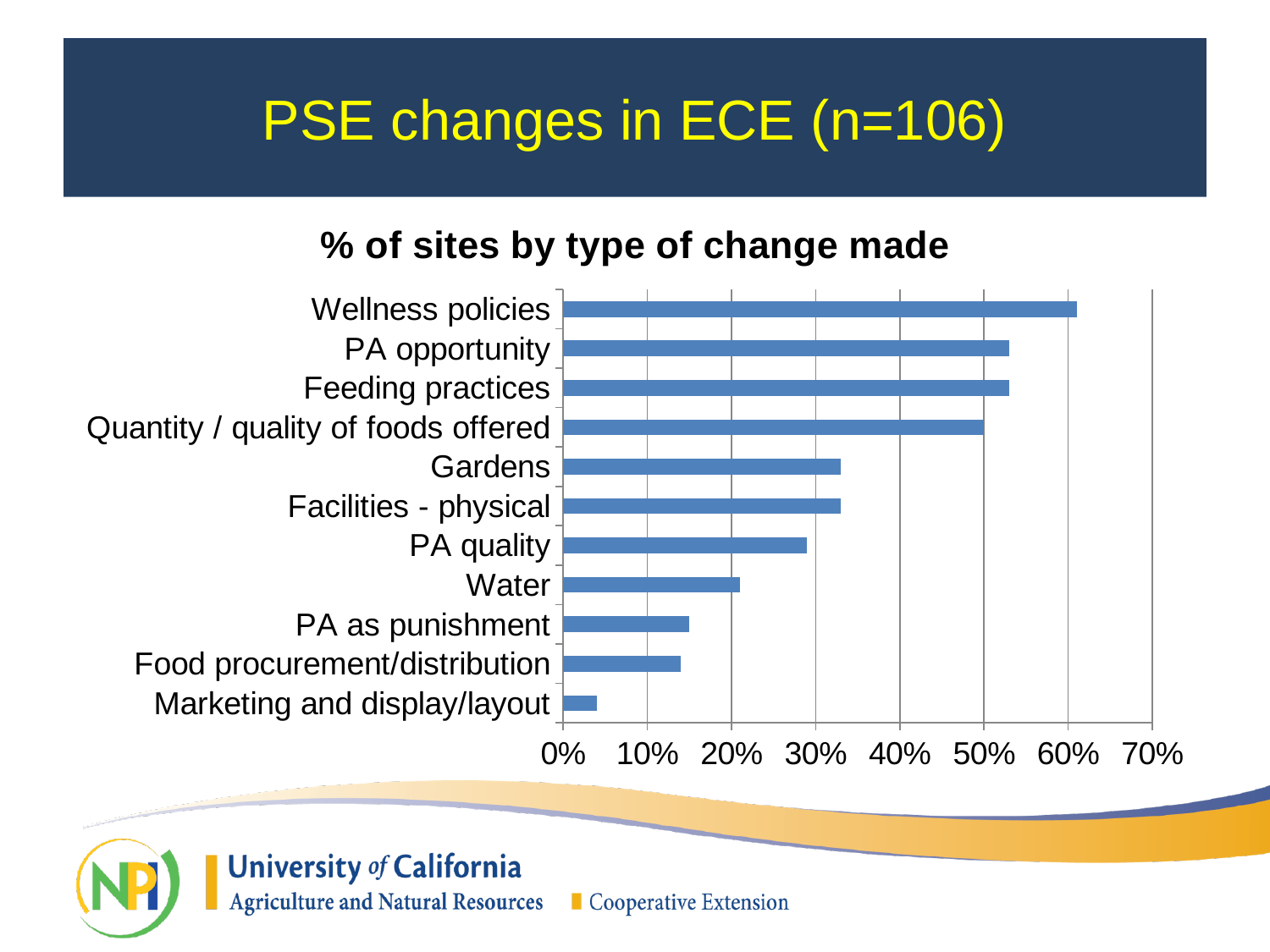
Which has a higher percentage of sites, PA quality or PA as punishment? PA quality Is the value for Gardens greater or less than 30%? greater Is the value for Marketing and display/layout greater or less than 10%? less Which type of change has the highest percentage of sites? Wellness policies What is the title of the chart? % of sites by type of change made Is the value for Water greater or less than 30%? less Which type of change has the lowest percentage of sites? Marketing and display/layout Which has a higher percentage of sites, Wellness policies or Water? Wellness policies How many types of change are listed on the chart? 11 What kind of chart is shown on the slide? bar chart